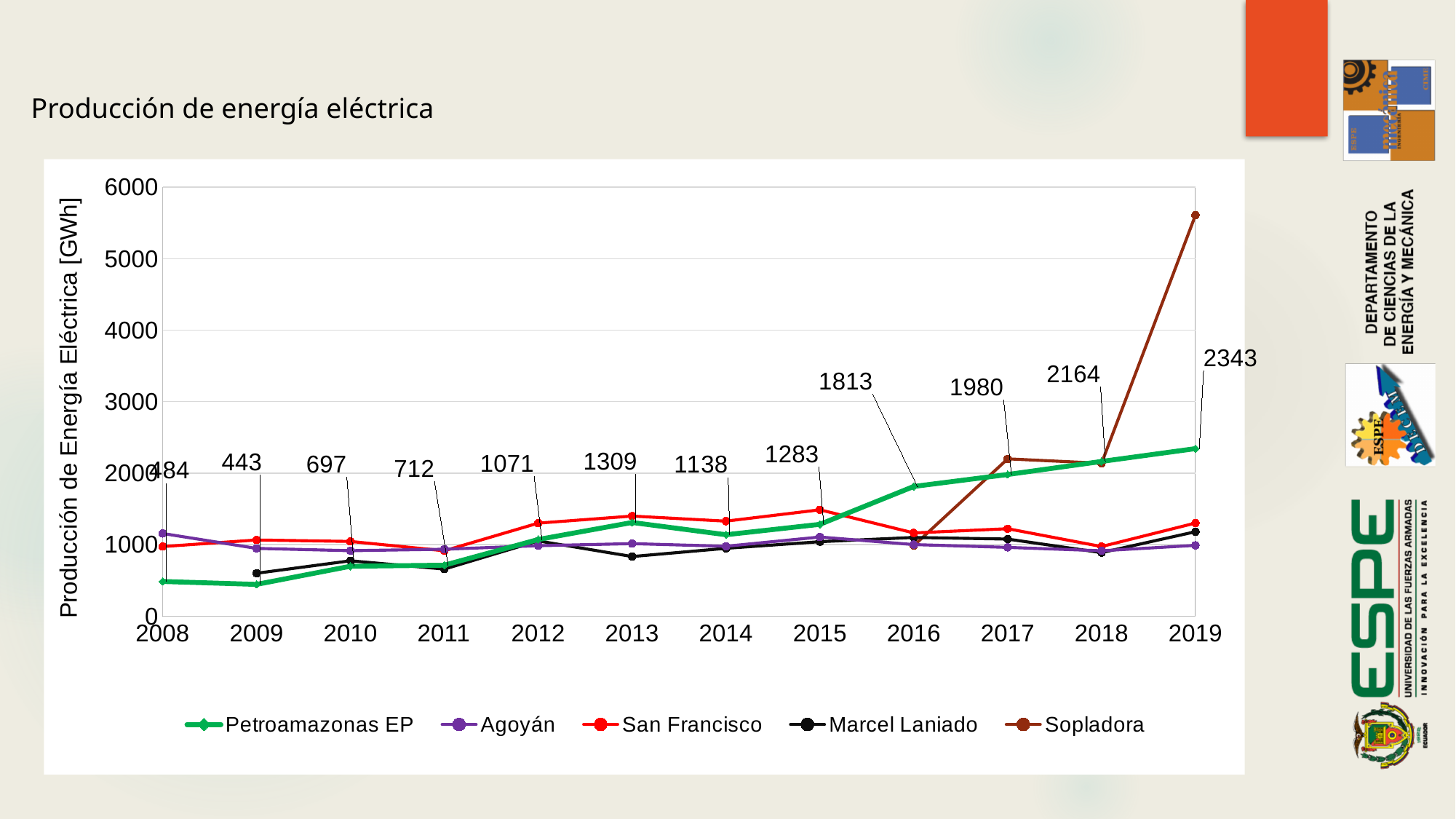
How many years are shown on the x axis? 12 What is the difference between the Petroamazonas EP values in 2019 and 2018? 179 What is the value for Petroamazonas EP in 2013? 1309 How many series does the legend list? 5 Which is larger for Petroamazonas EP: the value in 2013 or the value in 2014? 2013 In which year is the Petroamazonas EP value highest? 2019 What is the value for Petroamazonas EP in 2019? 2343 Is the value for Sopladora in 2019 greater or less than 5000? greater What is the label of the y axis? Producción de Energía Eléctrica [GWh] What is the value for Petroamazonas EP in 2016? 1813 In which year is the Petroamazonas EP value lowest? 2009 What kind of chart is shown on the slide? line chart